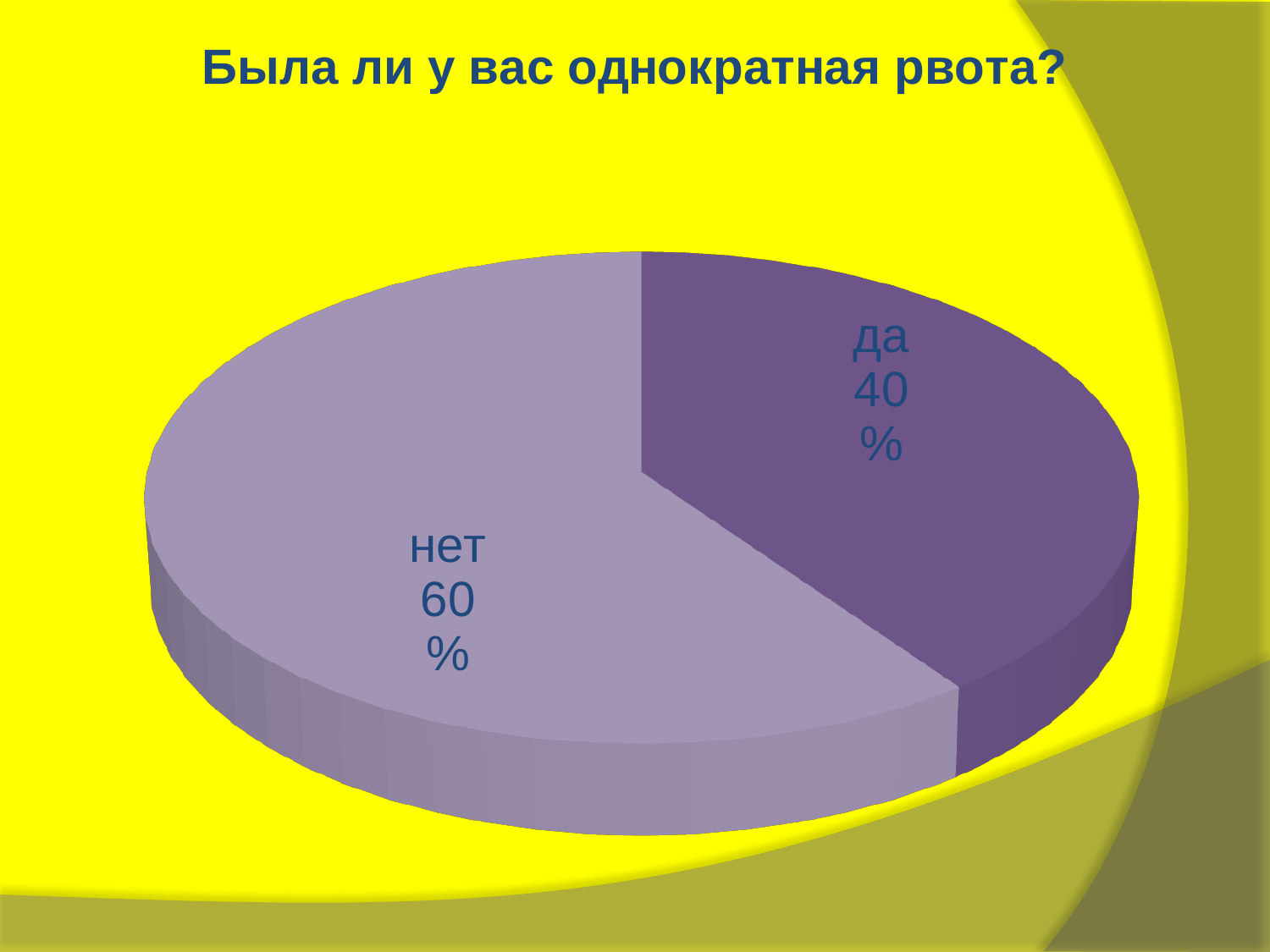
What share of the pie is labelled "да"? 40% Which slice is the largest? нет How many slices does the pie chart have? 2 Which slice is shown in the darker purple colour? да Which slice is the smallest? да Which is larger, the "да" slice or the "нет" slice? нет What is the difference in percentage points between the "нет" and "да" slices? 20% What kind of chart is shown on the slide? pie chart What share of the pie is labelled "нет"? 60% What is the title of the chart? Была ли у вас однократная рвота? Is the share for "да" greater or less than 50%? less